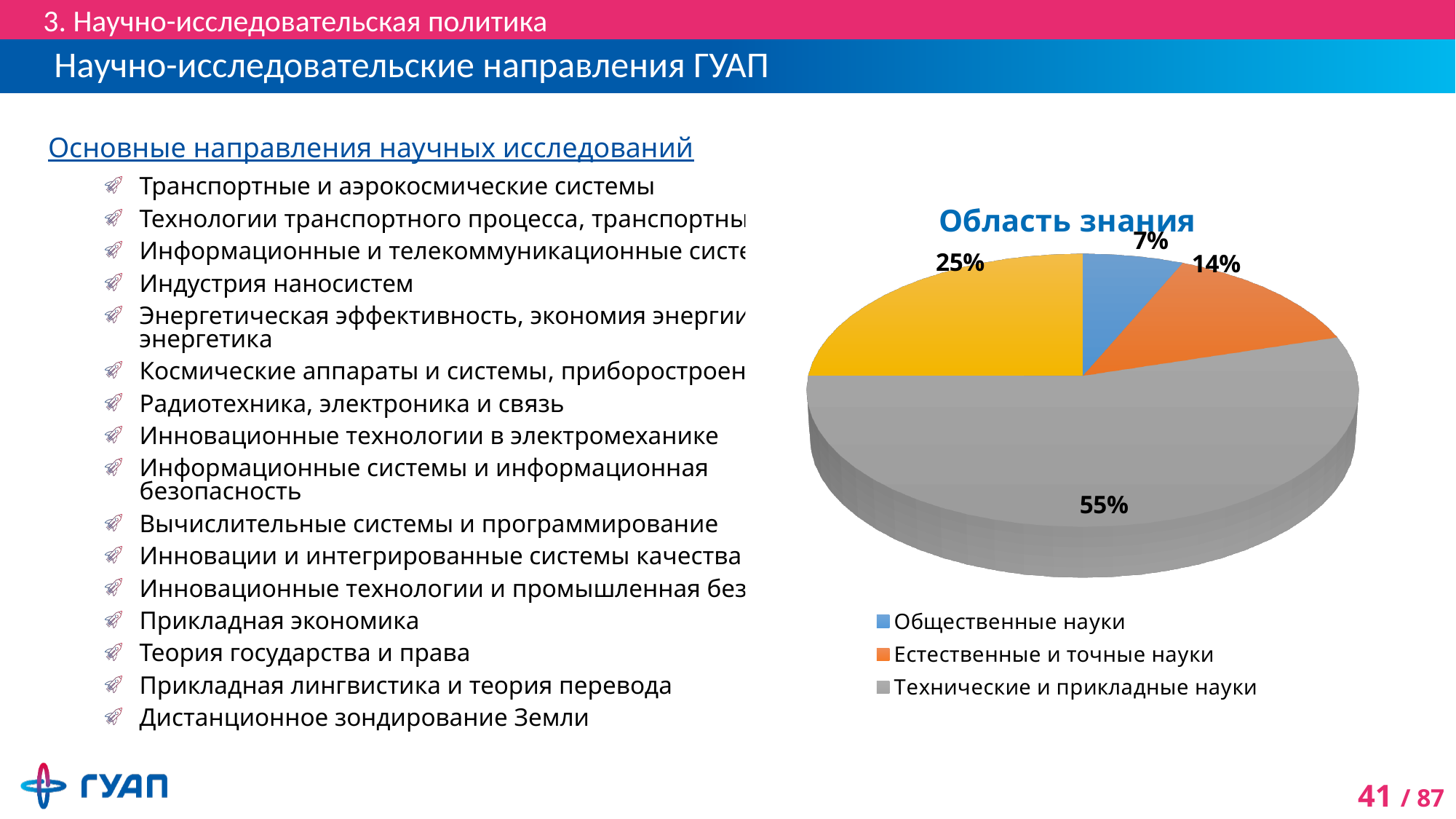
Which category has the smallest slice in the pie chart 'Область знания'? Общественные науки What colour is the slice for Технические и прикладные науки in the pie chart? Gray How many slices does the pie chart 'Область знания' have? 4 In the pie chart 'Область знания', how many percentage points larger is Технические и прикладные науки than Естественные и точные науки? 41 percentage points In the pie chart 'Область знания', what percentage is shown on the yellow slice? 25% How many entries does the legend of the pie chart 'Область знания' list? 3 In the pie chart 'Область знания', what percentage is shown for Естественные и точные науки? 14% In the pie chart 'Область знания', which is larger: Естественные и точные науки or Общественные науки? Естественные и точные науки In the pie chart 'Область знания', what percentage is shown for Технические и прикладные науки? 55% Which category has the largest slice in the pie chart 'Область знания'? Технические и прикладные науки What type of chart is shown on the slide? Pie chart In the pie chart 'Область знания', what percentage is shown for Общественные науки? 7%